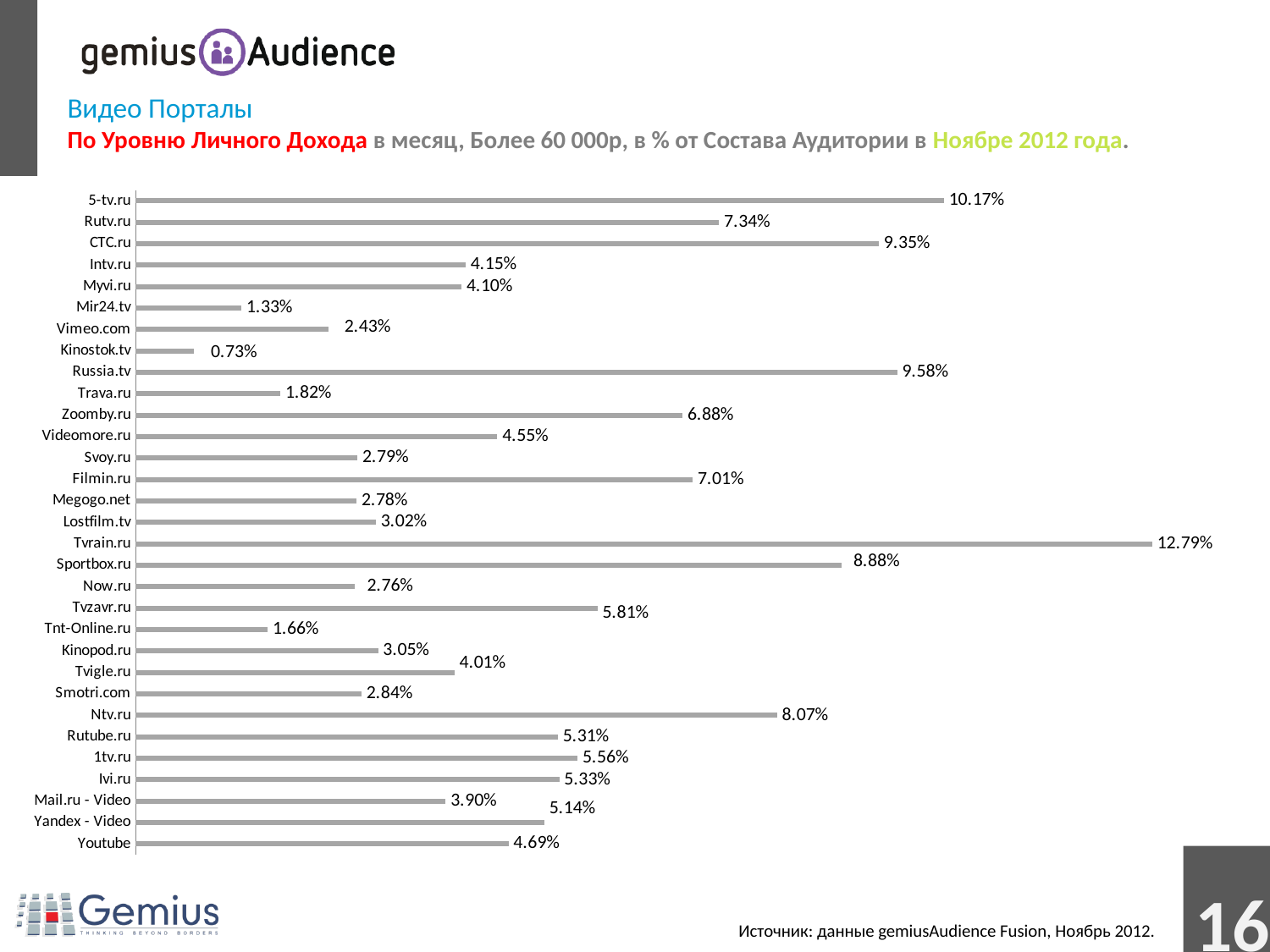
What is the value for Kinostok.tv? 0.73% Which portal has the lowest value? Kinostok.tv What is the value for Tvrain.ru? 12.79% What is the difference between the values for Russia.tv and CTC.ru? 0.23% What kind of chart is shown on the slide? Bar chart What is the value for Sportbox.ru? 8.88% Which has a larger value, Mail.ru - Video or Yandex - Video? Yandex - Video Which has a larger value, Ntv.ru or Filmin.ru? Ntv.ru What is the value for Youtube? 4.69% What is the difference between the values for 5-tv.ru and Rutv.ru? 2.83% How many portals are shown in the chart? 31 Which portal has the highest value? Tvrain.ru